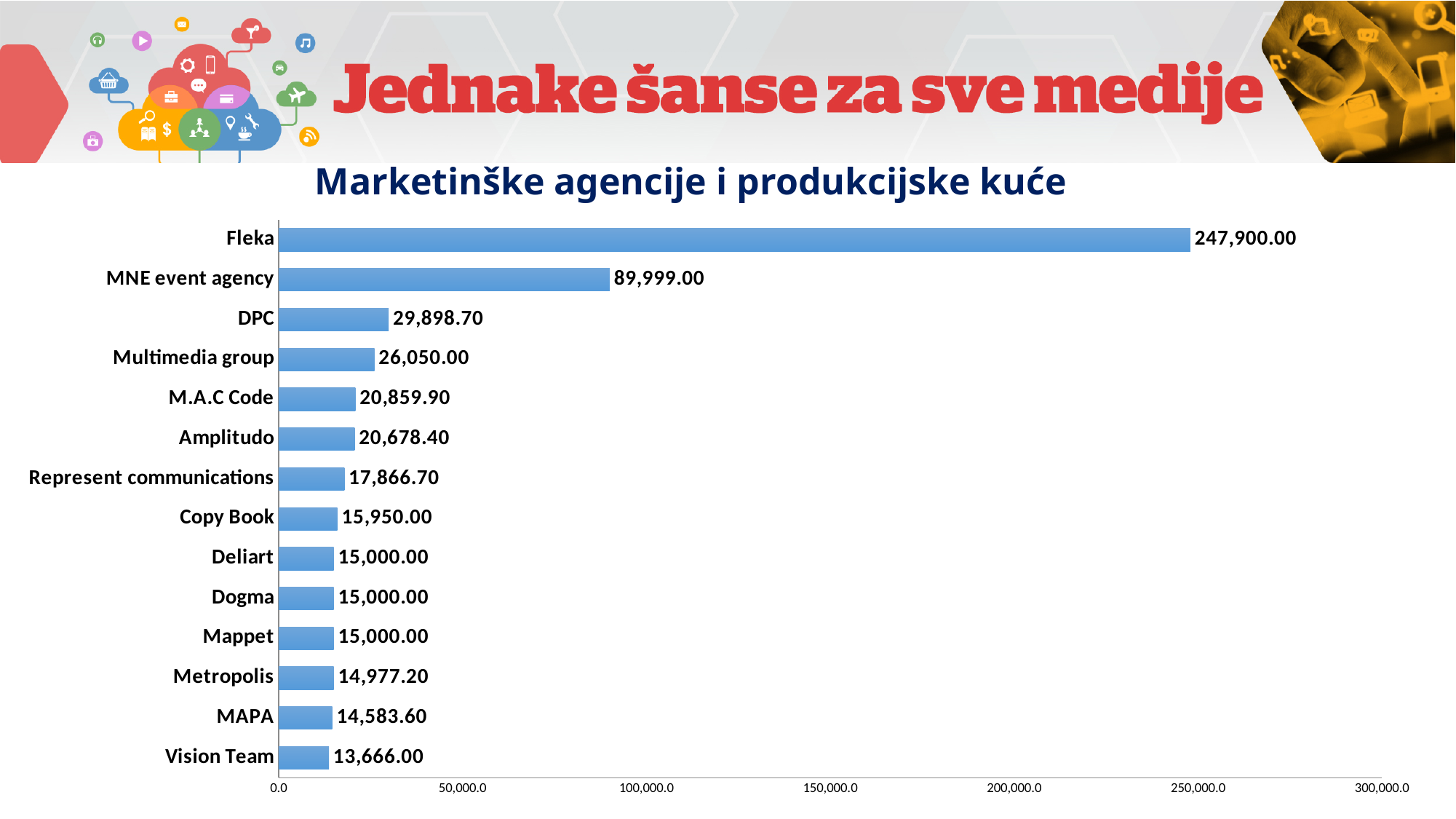
What is the difference between the values for Fleka and MNE event agency? 157,901.00 What is the value for DPC? 29,898.70 What is the title of the chart? Marketinške agencije i produkcijske kuće What is the difference between the values for Multimedia group and Copy Book? 10,100.00 How many categories are shown in the chart? 14 Which category has the lowest value? Vision Team What is the value for Represent communications? 17,866.70 Which category has the highest value? Fleka Is the value for MNE event agency greater or less than 100,000.0? less Which is larger, the value for DPC or the value for Multimedia group? DPC What kind of chart is shown on the slide? bar chart What is the value for Fleka? 247,900.00